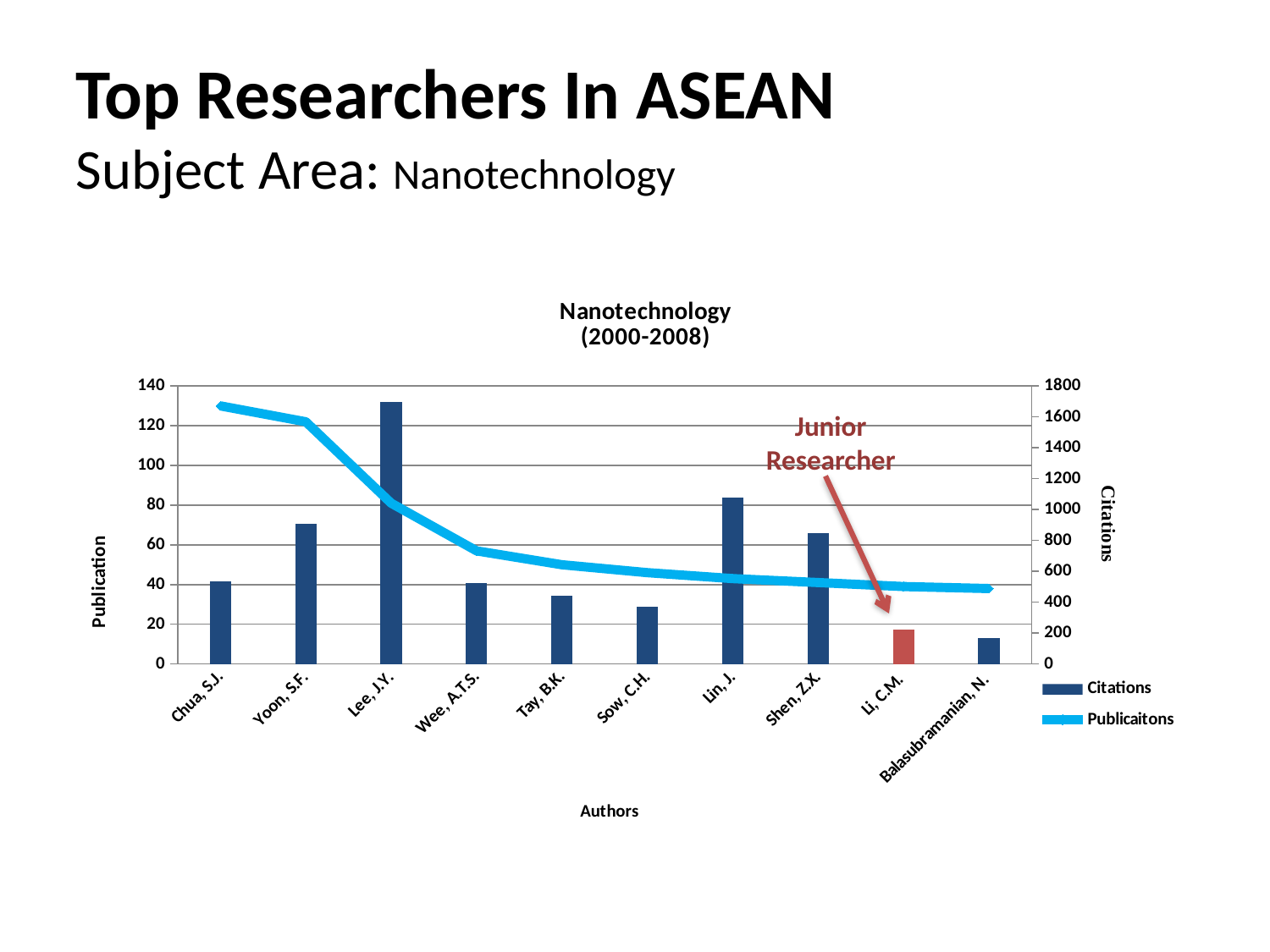
What is the title of the chart? Nanotechnology (2000-2008) How many authors are shown on the x axis of the chart? 10 How many series does the chart legend list? 2 Which author has the tallest bar in the chart? Lee, J.Y. Is the bar for Lee, J.Y. greater or less than 120 on the left axis? greater Which author has the taller bar, Yoon, S.F. or Shen, Z.X.? Yoon, S.F. Is the bar for Sow, C.H. greater or less than 40 on the left axis? less Which author is labelled as the Junior Researcher on the chart? Li, C.M. What kind of chart is shown on the slide? A combined bar and line chart Does the line series rise or fall moving from Chua, S.J. to Balasubramanian, N. along the x axis? It falls Which author has the shortest bar in the chart? Balasubramanian, N.